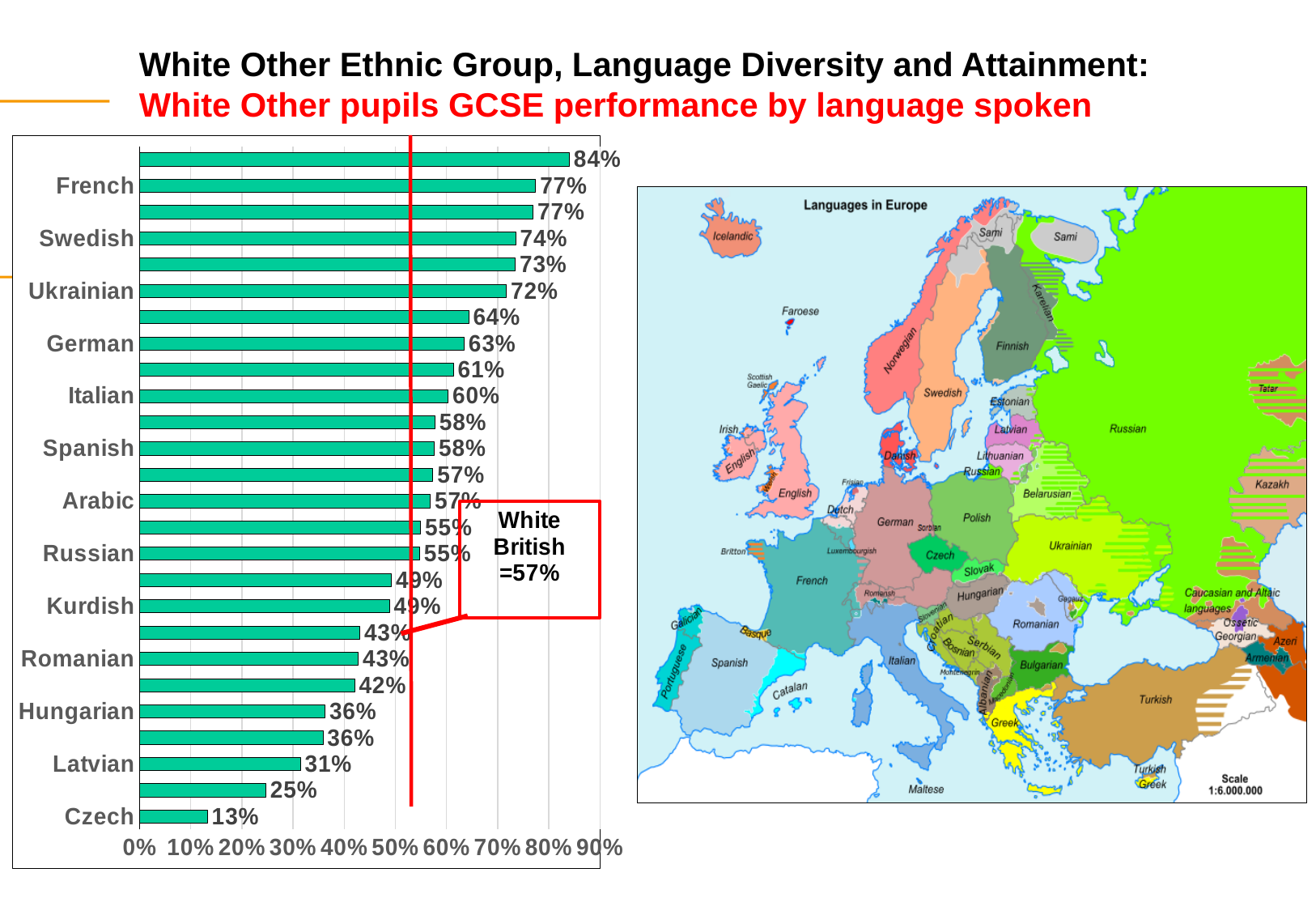
What is the difference between the values for French and Czech in the bar chart? 64 percentage points What is the value shown for Swedish in the bar chart? 74% What is the highest value shown on any bar in the chart? 84% What is the value shown for Czech in the bar chart? 13% What kind of chart is used to show GCSE performance by language spoken? Bar chart What is the GCSE performance value for French speakers in the bar chart? 77% Which labelled language has the lowest value in the bar chart? Czech Which has the larger value in the bar chart, Italian or Spanish? Italian How many bars are plotted in the bar chart? 26 What is the value shown for German in the bar chart? 63% Is the value for Hungarian in the bar chart greater or less than 40%? less What value does the red vertical reference line in the bar chart represent for White British pupils? 57%